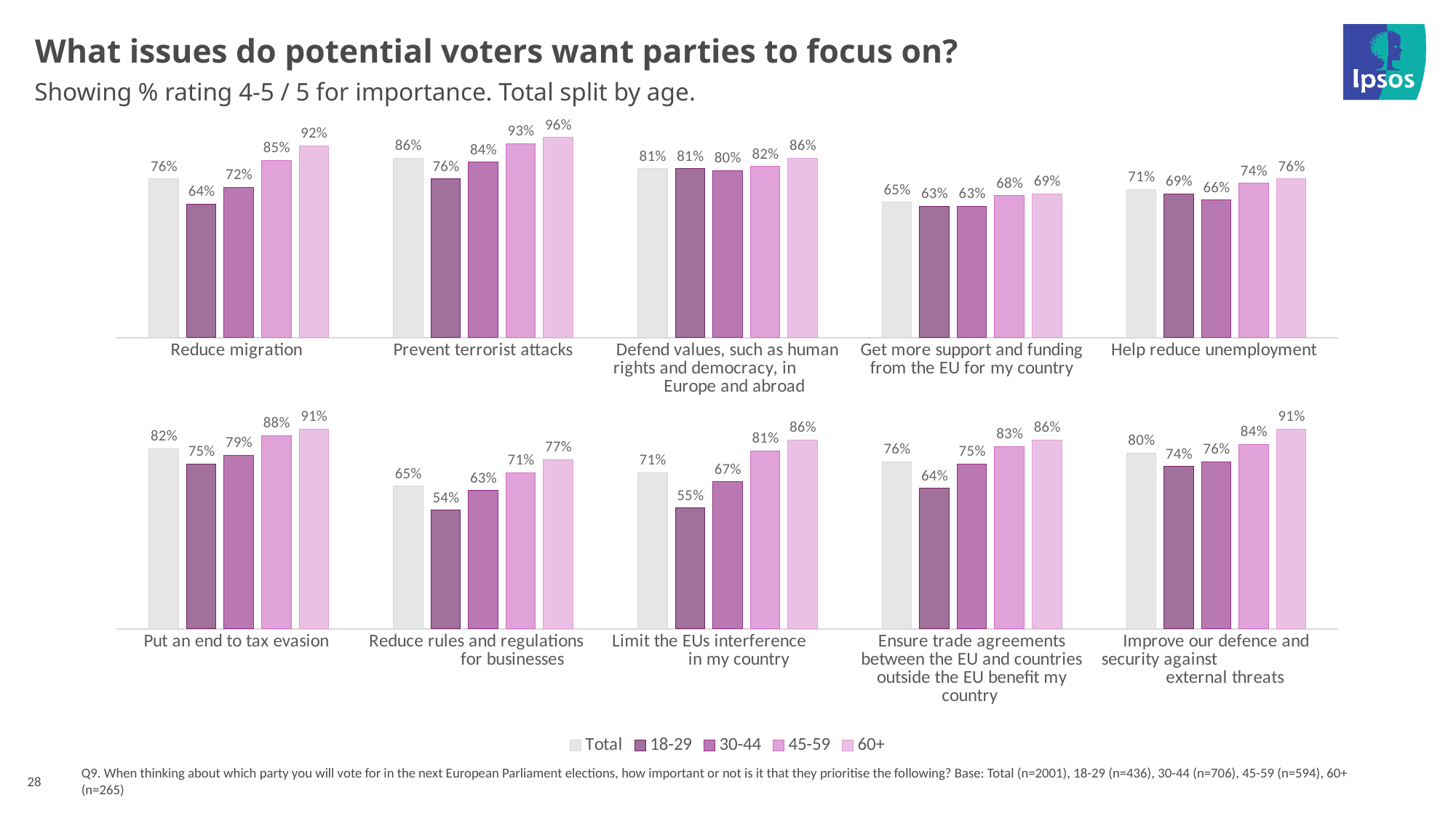
In the bottom chart, what is the difference between the 60+ and 18-29 values for Limit the EUs interference in my country? 31 percentage points In the top chart, what is the value for the 60+ group for Reduce migration? 92% In the bottom chart, what is the value for the 18-29 group for Reduce rules and regulations for businesses? 54% In the top chart, which is larger for Help reduce unemployment: the 18-29 value or the 30-44 value? 18-29 In the bottom chart, what is the difference between the Total values for Put an end to tax evasion and Reduce rules and regulations for businesses? 17 percentage points In the top chart, what is the Total value for Prevent terrorist attacks? 86% In the top chart, which issue has the lowest Total value? Get more support and funding from the EU for my country How many issues are shown in the bottom chart? 5 In the bottom chart, what is the value for the 45-59 group for Limit the EUs interference in my country? 81% In the top chart, which issue has the highest Total value? Prevent terrorist attacks What kind of chart is used on this slide? Bar chart How many series does the legend list? 5